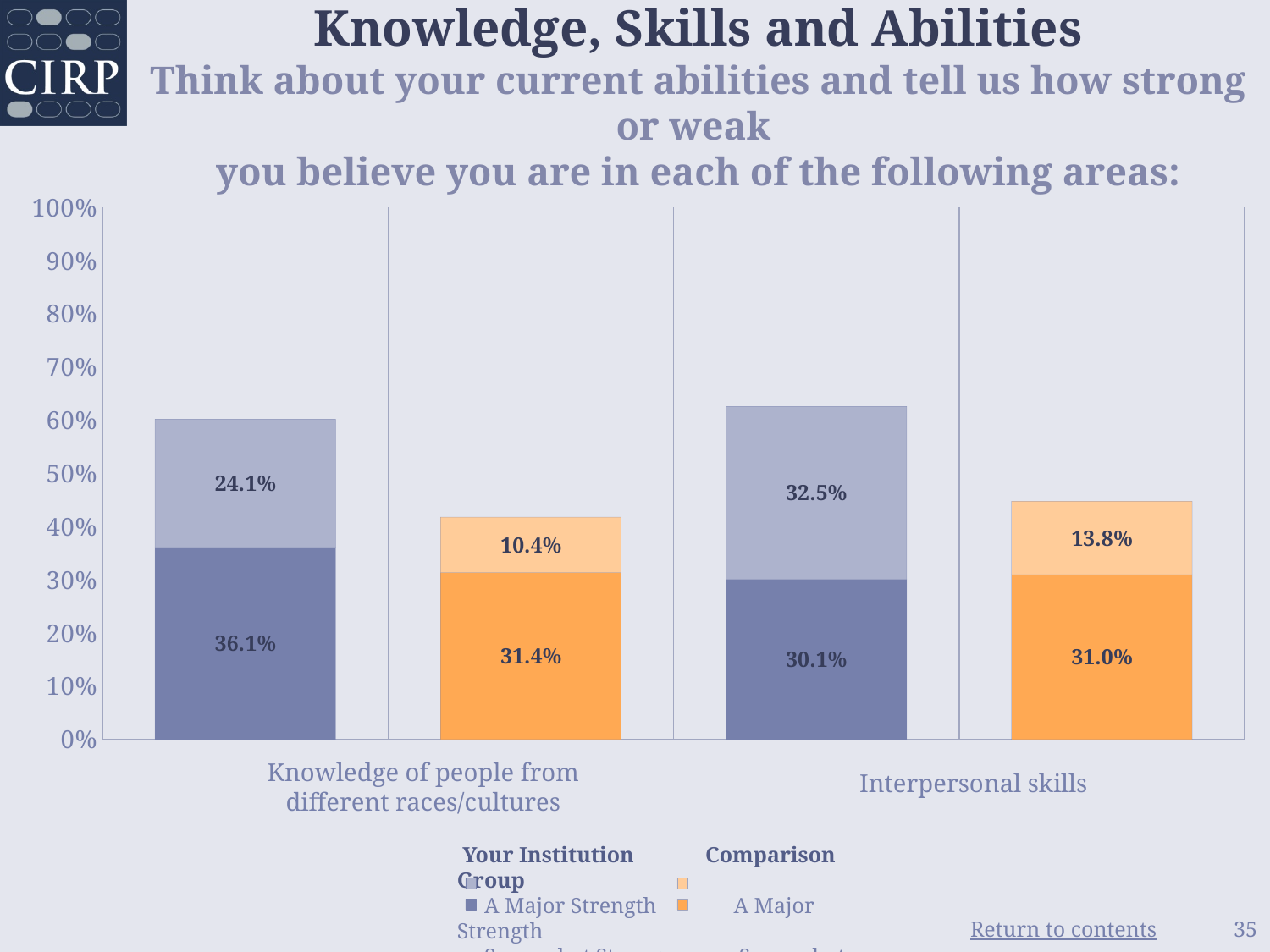
Which colour represents the Comparison Group bars? orange Which is larger for 'Interpersonal skills': the Your Institution upper segment (32.5%) or the Comparison Group upper segment (13.8%)? Your Institution (32.5%) What percentage of the Comparison Group rated 'Interpersonal skills' as A Major Strength? 31.0% What is the value of the upper (lighter) segment of the Your Institution bar for 'Interpersonal skills'? 32.5% What type of chart is shown on the slide? stacked bar chart What percentage of Your Institution respondents rated 'Knowledge of people from different races/cultures' as A Major Strength? 36.1% What is the total height of the Your Institution stacked bar for 'Knowledge of people from different races/cultures'? 60.2% Is the total of the Your Institution bar for 'Interpersonal skills' greater or less than 50%? greater How many ability areas (categories) are shown on the x axis? 2 What is the difference between the A Major Strength values for Your Institution and the Comparison Group on 'Knowledge of people from different races/cultures'? 4.7% What is the total height of the Comparison Group stacked bar for 'Interpersonal skills'? 44.8% What is the value of the upper (lighter) segment of the Comparison Group bar for 'Knowledge of people from different races/cultures'? 10.4%